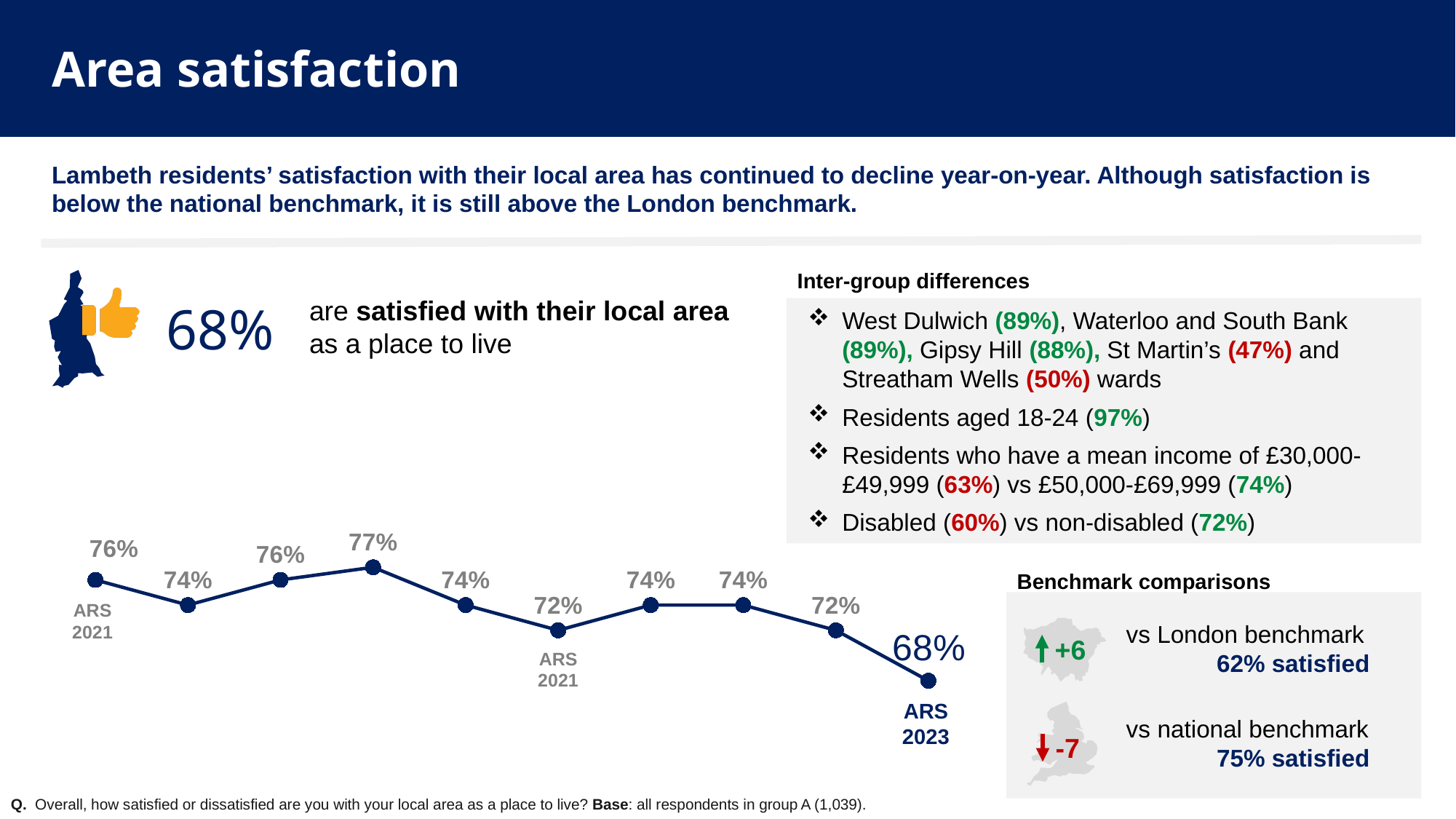
What is the satisfaction value shown for ARS 2023 on the line chart? 68% What is the lowest value shown on the line chart? 68% What is the highest value shown on the line chart? 77% How many points on the line chart are labelled 74%? 4 Overall, do the values on the line chart rise or fall from left to right? fall How many data points are plotted on the line chart? 10 What is the value of the first point on the line chart? 76% What kind of chart is used to show area satisfaction over time? line chart Which is larger on the line chart: the first point or the ARS 2023 point? the first point What is the difference between the highest value on the line chart (77%) and the ARS 2023 value (68%)? 9 percentage points What is the difference between the first point (76%) and the last point (68%) on the line chart? 8 percentage points Which point on the line chart has the lowest value? ARS 2023